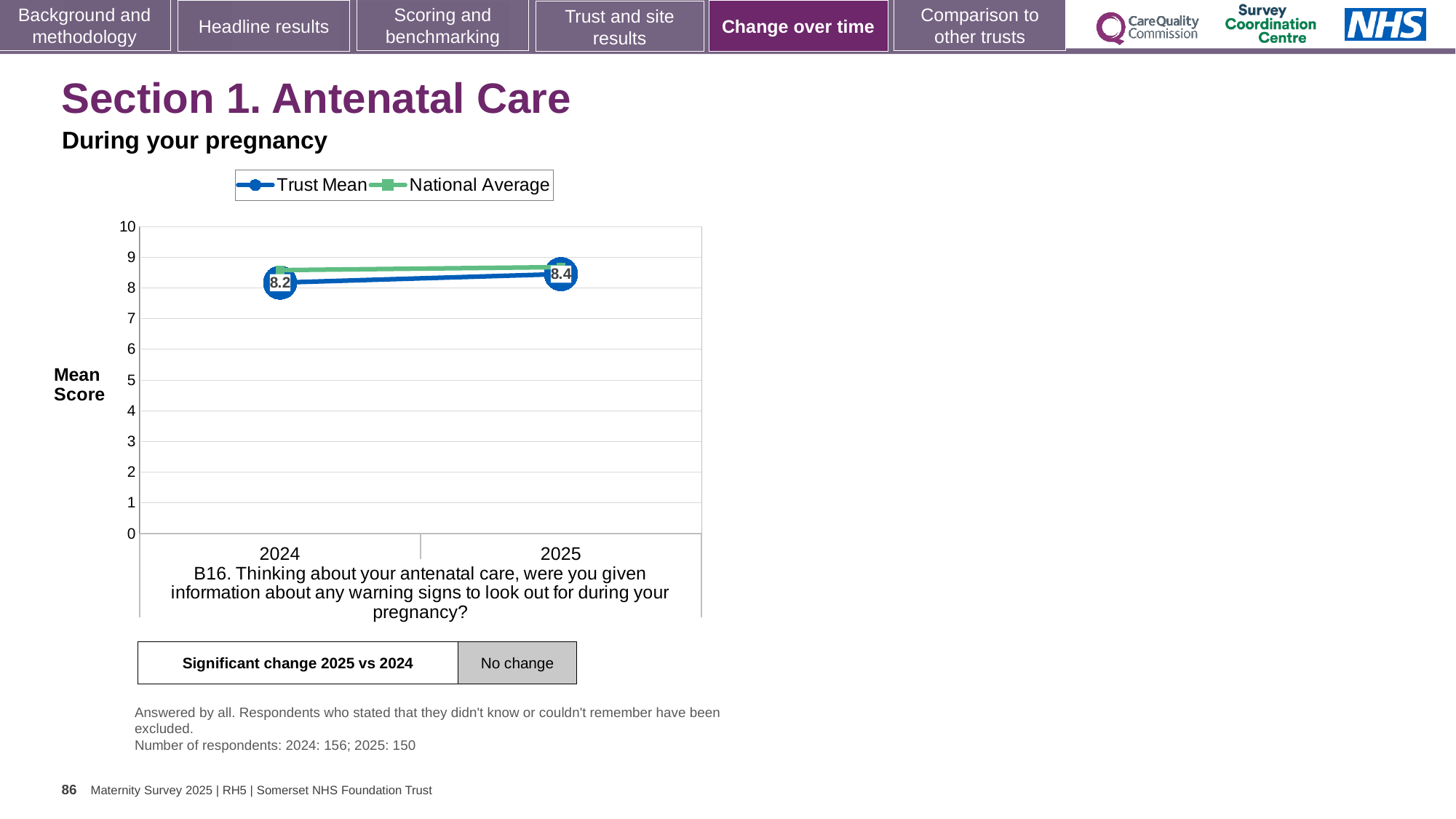
Is the National Average value for 2024 greater or less than 8? greater How many years are plotted on the x axis? 2 What kind of chart is shown on the slide? line chart What is the Trust Mean score for 2025? 8.4 In 2024, which is higher, the Trust Mean or the National Average? National Average Does the Trust Mean rise or fall from 2024 to 2025? rise What is the Trust Mean score for 2024? 8.2 Which year has the higher Trust Mean score, 2024 or 2025? 2025 Is the National Average value for 2025 greater or less than 9? less By how much did the Trust Mean score change from 2024 to 2025? 0.2 How many series does the legend list? 2 What is the label on the y axis of the chart? Mean Score